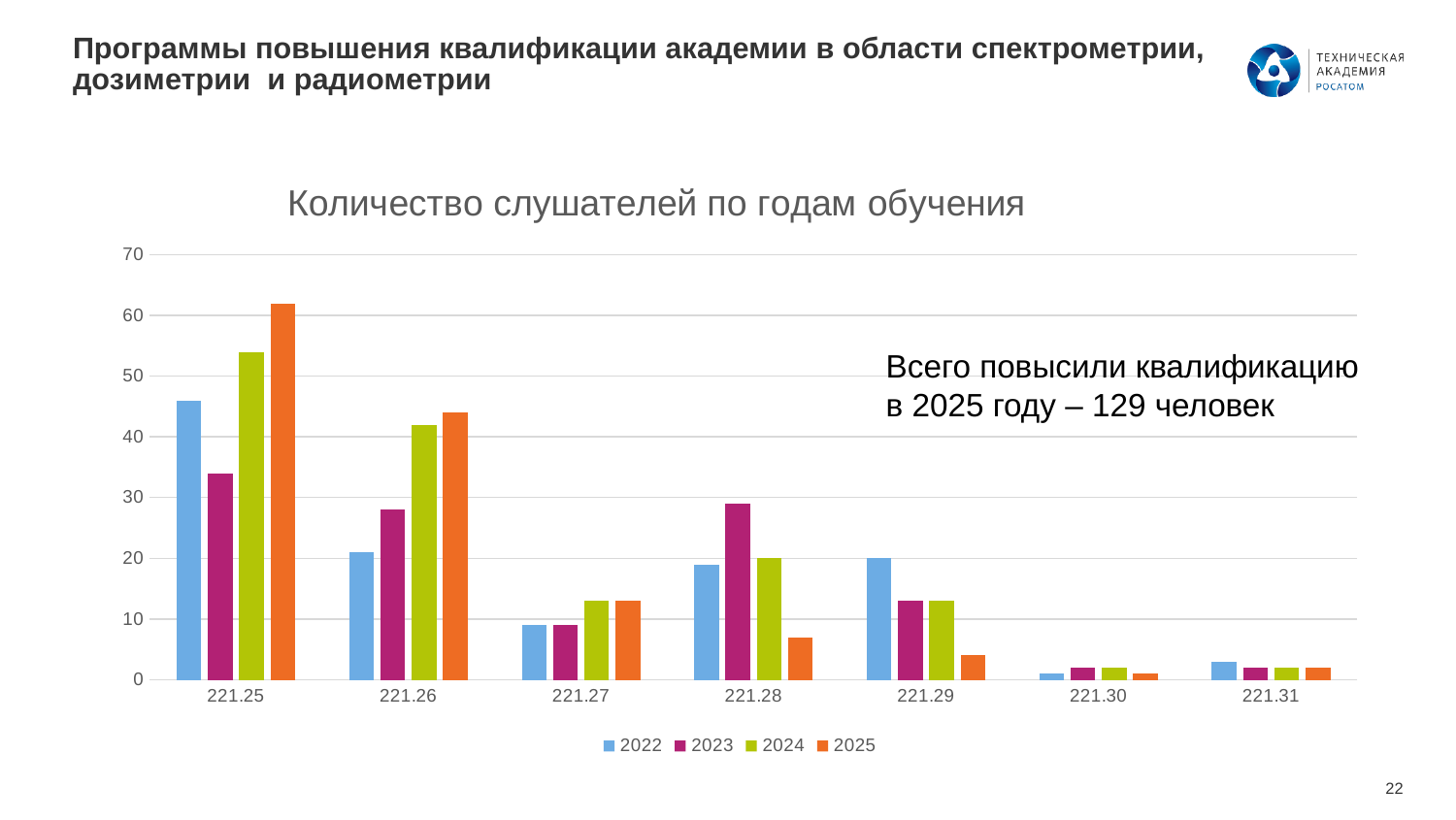
What is the title of the chart? Количество слушателей по годам обучения Is the value for 2022 in category 221.27 greater or less than 10? less Is the value for 2025 in category 221.25 greater or less than 50? greater How many categories are shown on the x axis? 7 Which category has the lowest 2022 bar? 221.30 Which series has the highest bar in category 221.28? 2023 What kind of chart is shown on the slide? bar chart Which category has the highest 2025 bar? 221.25 In category 221.29, which is larger: the 2022 bar or the 2025 bar? 2022 In category 221.25, which is larger: the 2023 bar or the 2024 bar? 2024 How many series does the legend list? 4 Is the value for 2024 in category 221.26 greater or less than 30? greater